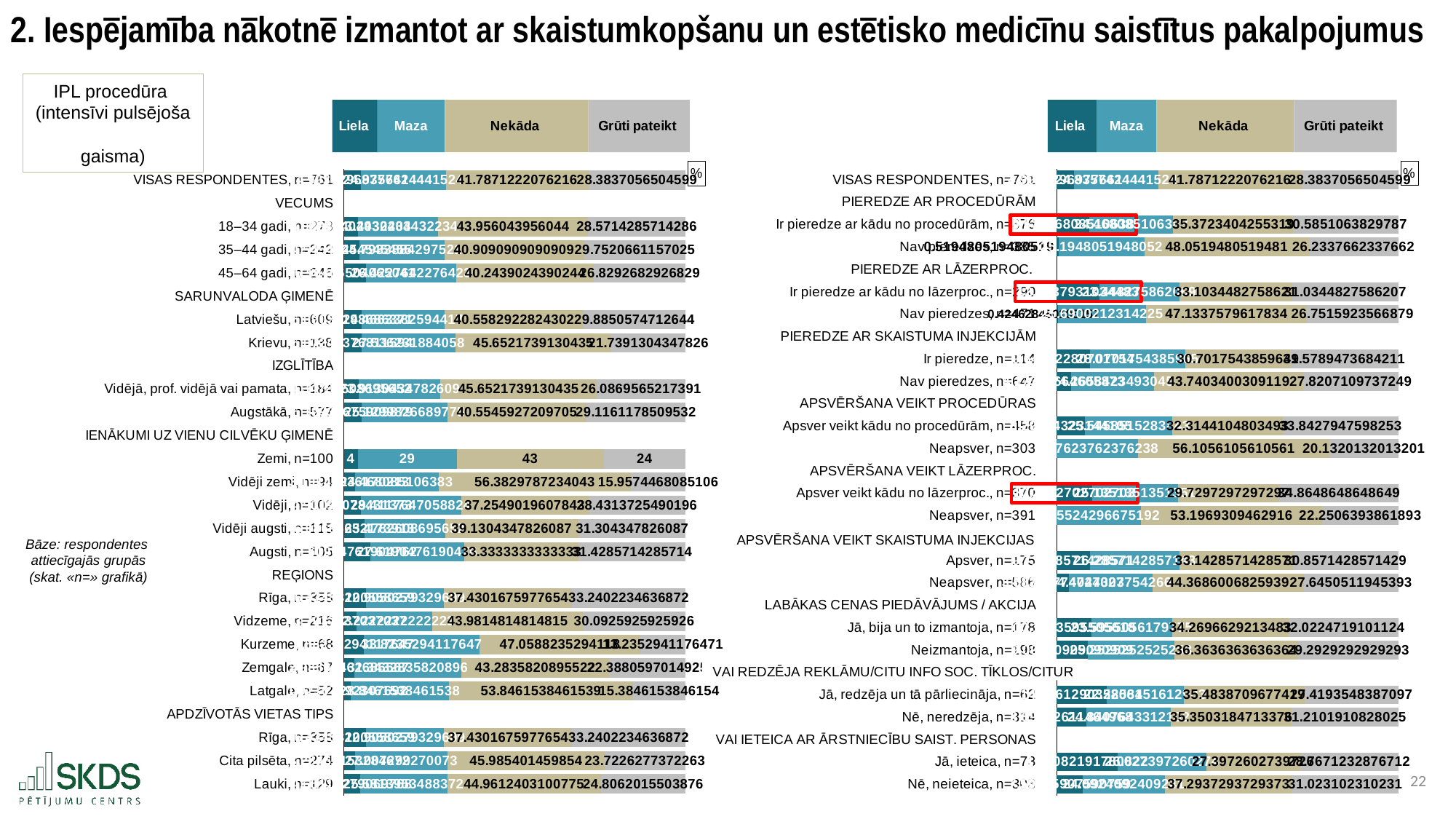
What are the four legend entries shown above the charts? Liela, Maza, Nekāda, Grūti pateikt In the left chart, what is the difference between 'Nekāda' and 'Grūti pateikt' for the row 'Zemi, n=100'? 19 In the left chart, for the row 'Zemi, n=100', which is larger: 'Maza' or 'Grūti pateikt'? Maza In the left chart, which response category has the highest value in the row 'Zemi, n=100'? Nekāda In the left chart, what is the value of 'Liela' for the row 'Zemi, n=100'? 4 What kind of chart is used on this slide? Stacked bar chart In the left chart, what is the value of 'Nekāda' for the row 'Zemi, n=100'? 43 In the left chart, what is the total of the stacked bar for 'Zemi, n=100'? 100 How many series does the legend list for the charts on this slide? 4 In the left chart, is the 'Nekāda' value for 'Latgale, n=52' greater or less than 50? greater In the left chart, what is the value of 'Maza' for the row 'Zemi, n=100'? 29 In the left chart, what is the value of 'Grūti pateikt' for the row 'Zemi, n=100'? 24